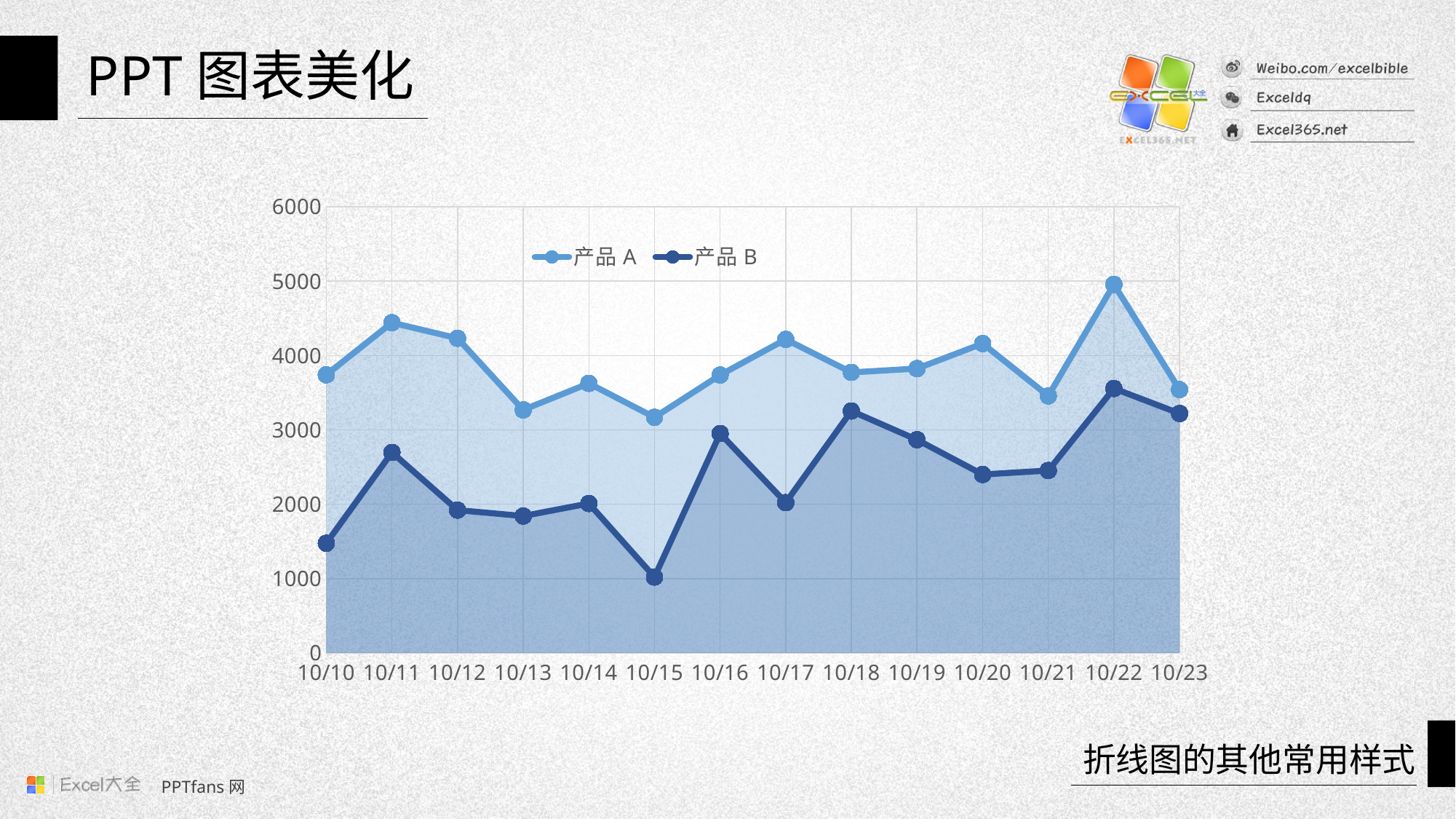
Is the value for 产品 B on 10/10 greater or less than 2000? less Does the value for 产品 B rise or fall from 10/15 to 10/16? rise On 10/11, which series has the larger value, 产品 A or 产品 B? 产品 A How many dates are shown along the x axis? 14 Is the value for 产品 B on 10/15 greater or less than 2000? less How many series does the legend list? 2 On which date does 产品 B reach its lowest value? 10/15 On which date does 产品 B reach its highest value? 10/22 What kind of chart is shown on the slide? line chart On which date does 产品 A reach its highest value? 10/22 Is the value for 产品 A on 10/22 greater or less than 4000? greater What are the two series named in the legend? 产品 A and 产品 B